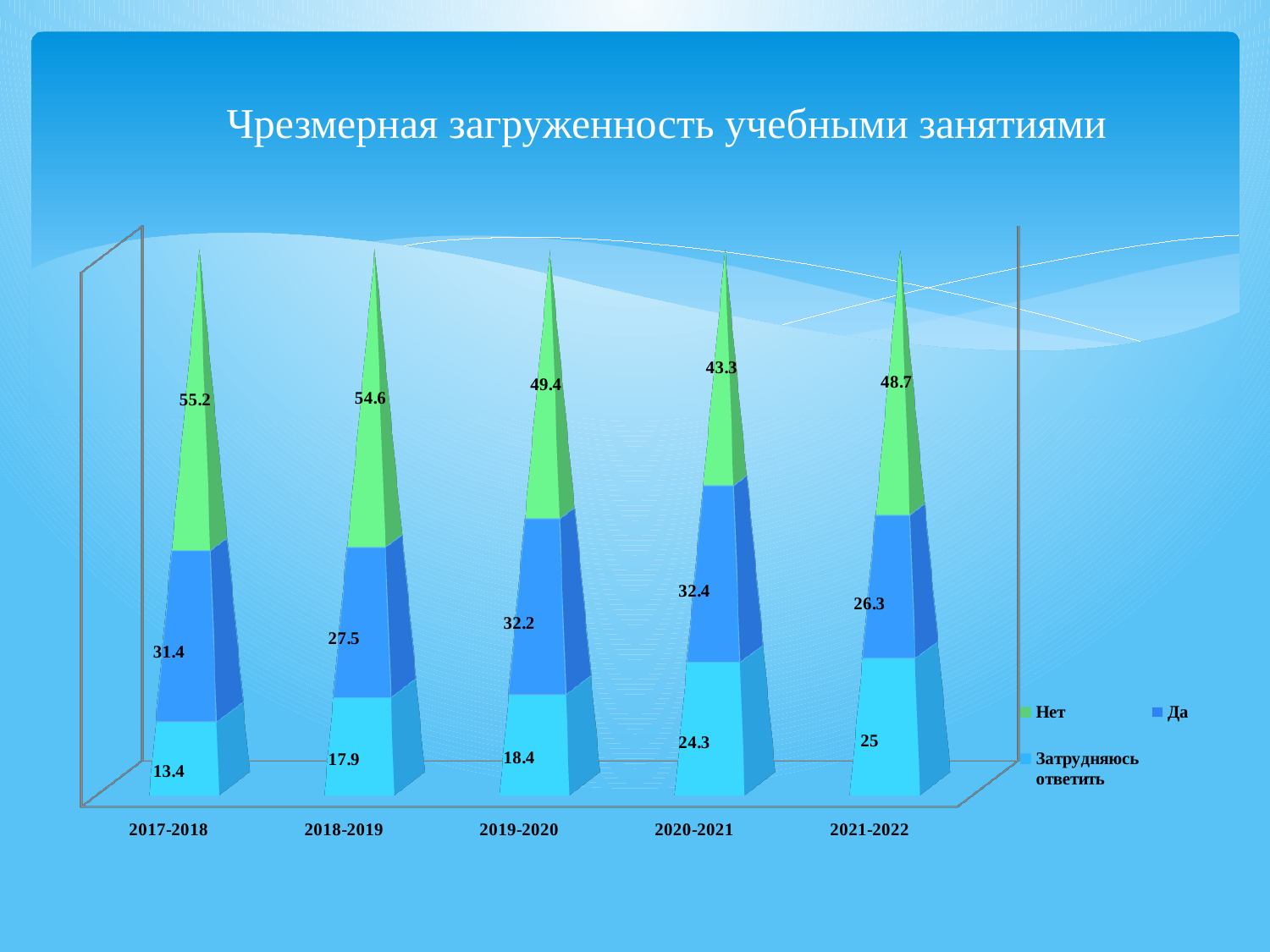
Which is larger: the "Да" value for 2019-2020 or for 2021-2022? 2019-2020 In which year is the value for "Нет" the lowest? 2020-2021 What is the value for "Да" in 2020-2021? 32.4 In which year is the value for "Затрудняюсь ответить" the highest? 2021-2022 How many year categories are shown on the x axis? 5 What is the total of the stacked bar for 2018-2019? 100 What kind of chart is shown on the slide? Stacked bar chart What is the difference between the "Нет" values for 2017-2018 and 2021-2022? 6.5 How many series does the legend list? 3 What is the title of the chart? Чрезмерная загруженность учебными занятиями What is the value for "Нет" in 2017-2018? 55.2 What is the value for "Затрудняюсь ответить" in 2021-2022? 25